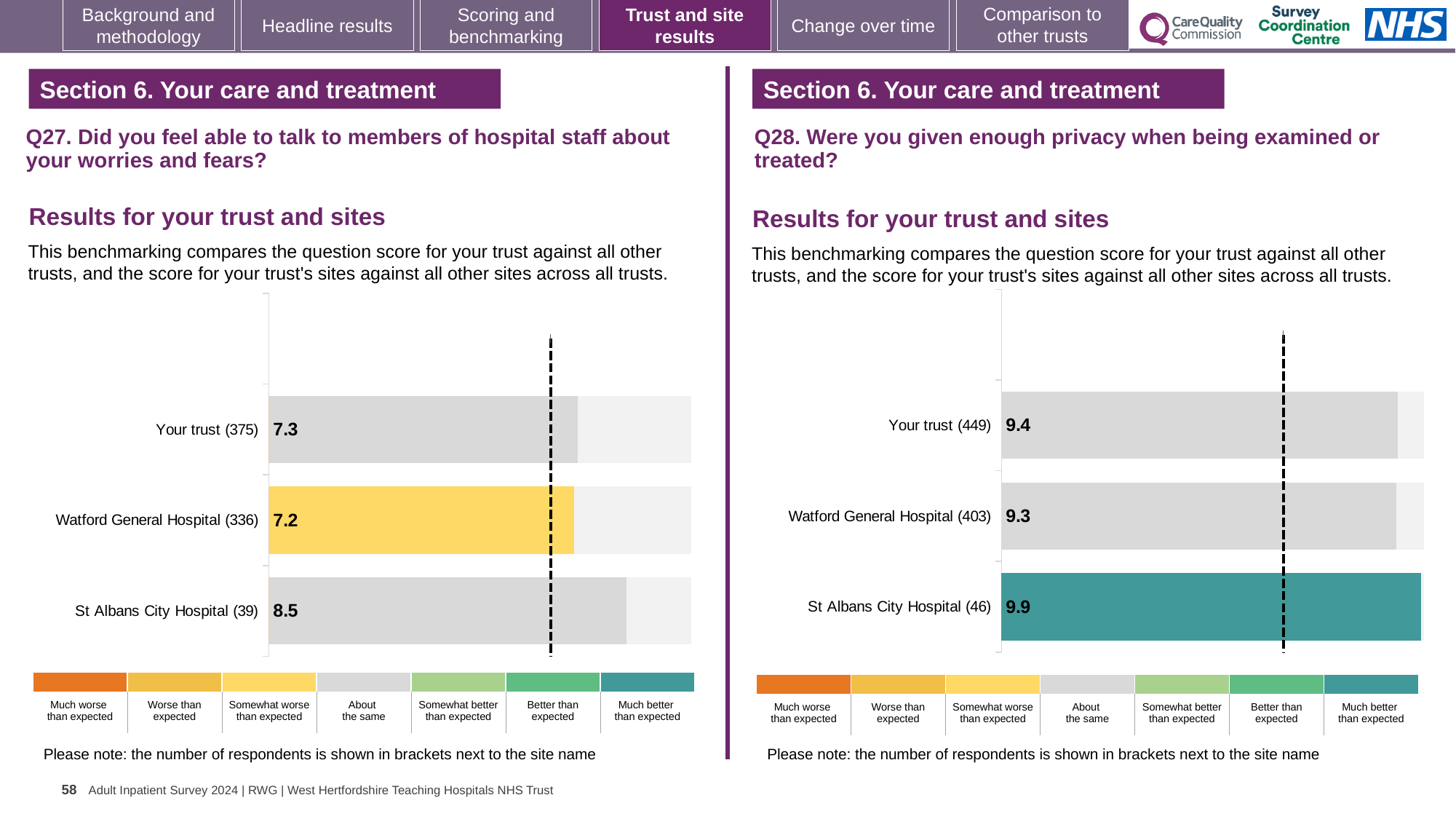
In the Q28 chart on the right, what is the score for Watford General Hospital? 9.3 In the Q28 chart on the right, what is the score for St Albans City Hospital? 9.9 In the Q27 chart on the left, which site or trust has the lowest score? Watford General Hospital In the Q28 chart on the right, what is the difference between the scores for St Albans City Hospital and Your trust? 0.5 In the Q27 chart on the left, what is the difference between the scores for St Albans City Hospital and Watford General Hospital? 1.3 How many bars are plotted in the Q28 chart on the right? 3 In the Q27 chart on the left, how many respondents are shown for Watford General Hospital? 336 In the Q28 chart on the right, which site or trust has the highest score? St Albans City Hospital In the Q27 chart on the left, which site or trust has the highest score? St Albans City Hospital In the Q27 chart on the left, what is the score for St Albans City Hospital? 8.5 In the Q27 chart on the left, what is the score for Your trust? 7.3 What type of chart is used in the Q27 chart on the left? Bar chart